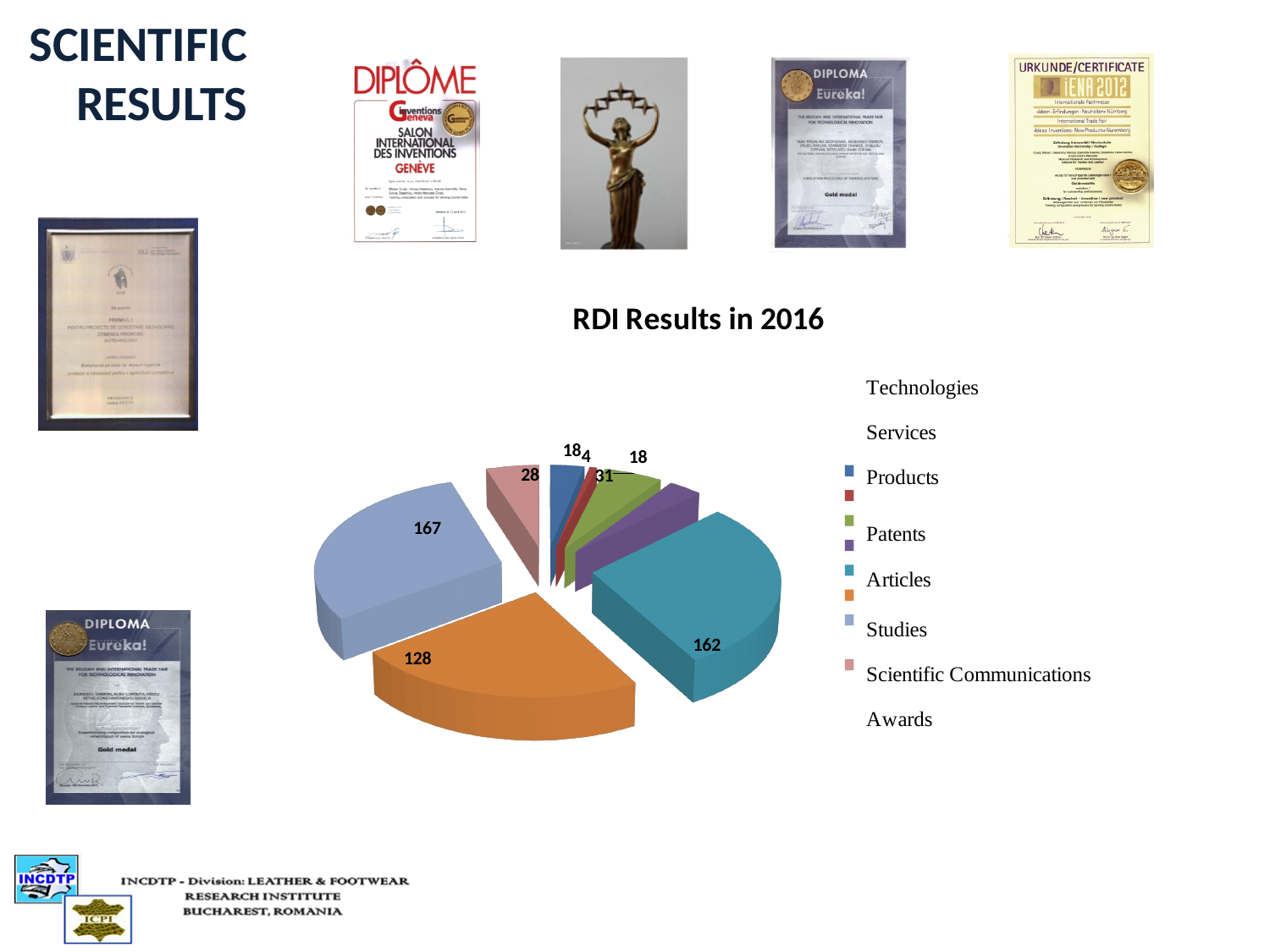
What is the difference between the two largest slice values on the pie chart, 167 and 162? 5 Which legend entry is listed last in the pie chart's legend? Awards What kind of chart is shown under the title "RDI Results in 2016"? pie chart What is the largest value labelled on the pie chart? 167 How many entries does the legend of the pie chart list? 8 What is the title of the chart on the slide? RDI Results in 2016 What is the total of all the values labelled on the pie chart? 556 What is the difference between the largest and smallest values labelled on the pie chart? 163 How many slices does the pie chart have? 8 What is the smallest value labelled on the pie chart? 4 Which is larger on the pie chart, the slice labelled 162 or the slice labelled 128? 162 How many slices on the pie chart are labelled with the value 18? 2